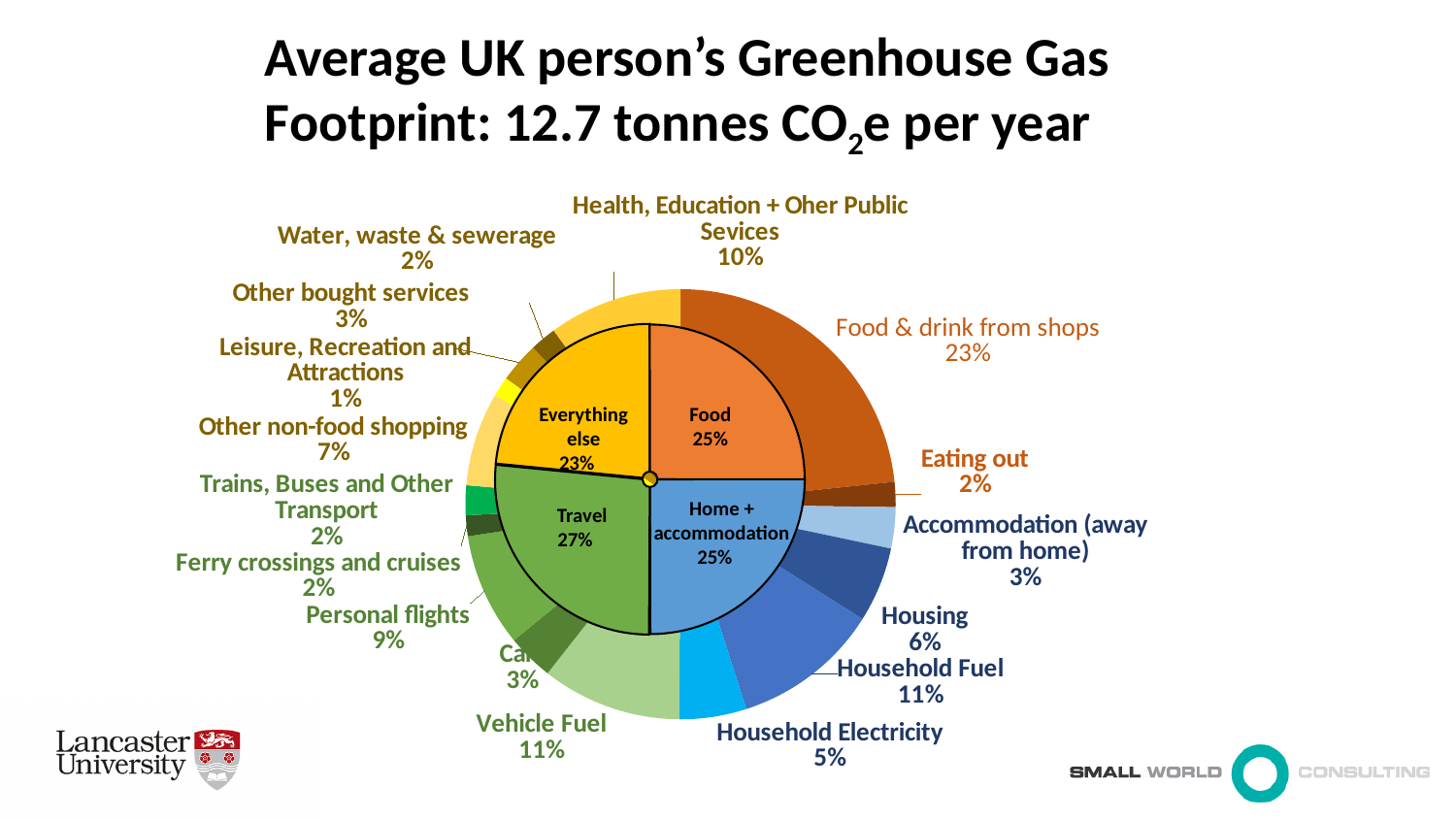
What share of the footprint is Household Fuel? 11% How many categories are shown in the inner ring? 4 Which outer-ring category has the smallest share? Leisure, Recreation and Attractions What share of the footprint is Personal flights? 9% What share of the footprint is Food & drink from shops? 23% Which of the four inner-ring categories has the largest share? Travel What kind of chart is shown on the slide? pie chart What share of the footprint is Other non-food shopping? 7% Which is larger, Housing or Household Electricity? Housing What is the chart's title? Average UK person's Greenhouse Gas Footprint: 12.7 tonnes CO2e per year What is the difference in percentage points between Food & drink from shops and Eating out? 21 What share of the footprint does Travel account for in the inner ring? 27%